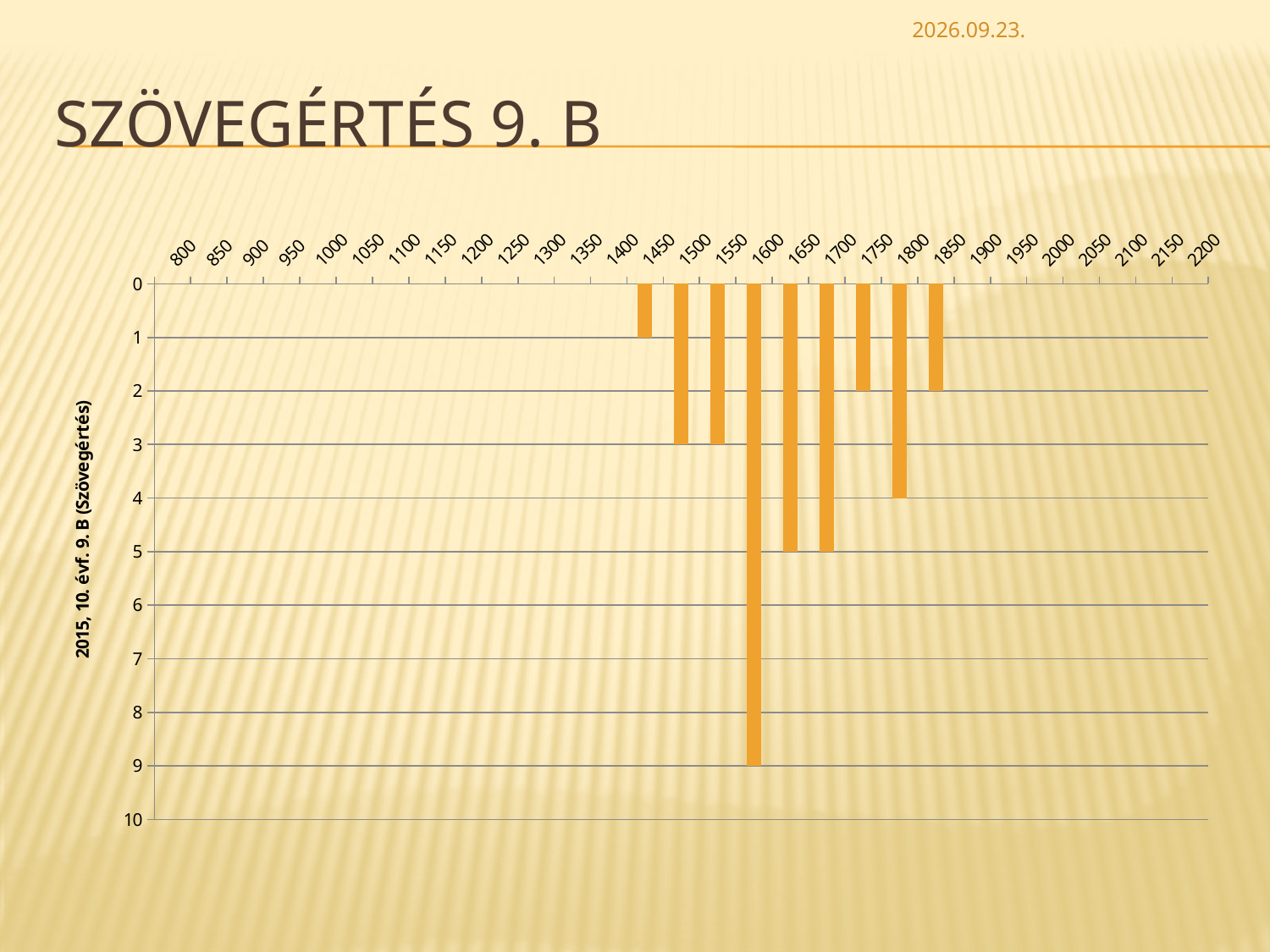
Which bar is longer: the one between 1450 and 1500 or the one between 1700 and 1750? the one between 1450 and 1500 What is the highest value reached by any bar in the chart? 9 What is the difference between the bar between 1550 and 1600 and the bar between 1600 and 1650? 4 How many bars are plotted in the chart? 9 What is the value of the shortest bar in the chart? 1 What kind of chart is shown on the slide? bar chart What is the value of the bar located between the 1400 and 1450 ticks? 1 What is the value of the bar located between the 1600 and 1650 ticks? 5 Between which two x-axis ticks does the longest bar sit? 1550 and 1600 Is the value of the bar between 1550 and 1600 greater or less than 5? greater What is the title of the vertical axis of the chart? 2015, 10. évf. 9. B (Szövegértés) What is the value of the bar located between the 1750 and 1800 ticks? 4